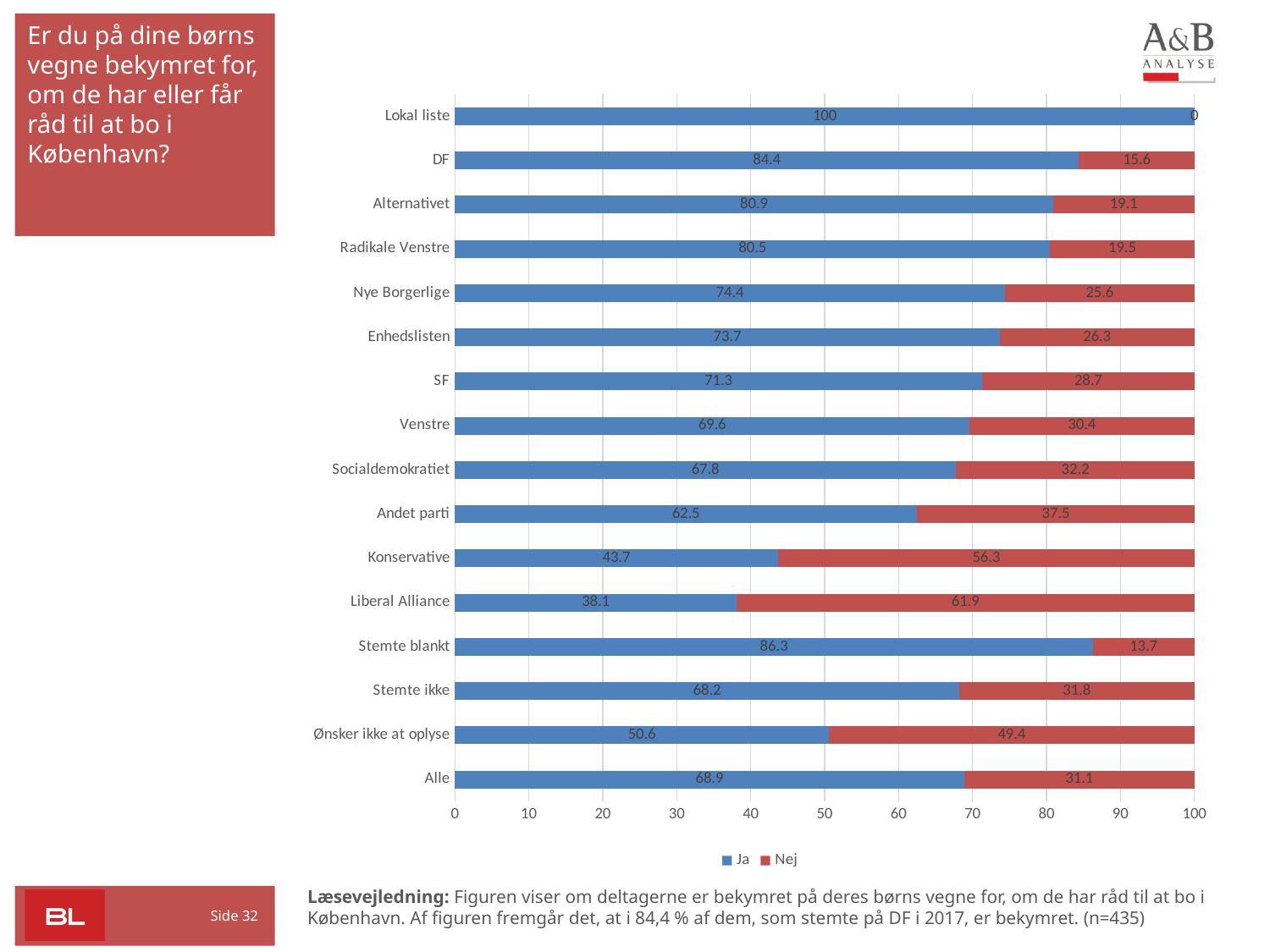
What is the 'Ja' value for DF? 84.4 What is the 'Ja' value for Alle? 68.9 What kind of chart is shown on the slide? Stacked bar chart What is the 'Nej' value for Liberal Alliance? 61.9 Is the 'Ja' value for Stemte blankt greater or less than 80? greater How many categories are shown on the chart? 16 Which category has the lowest 'Ja' value? Liberal Alliance What is the total of the stacked bar for Ønsker ikke at oplyse? 100 How many series does the legend list? 2 Which is larger, the 'Ja' value for SF or the 'Ja' value for Venstre? SF What is the difference between the 'Nej' and 'Ja' values for Konservative? 12.6 Which category has the highest 'Ja' value? Lokal liste